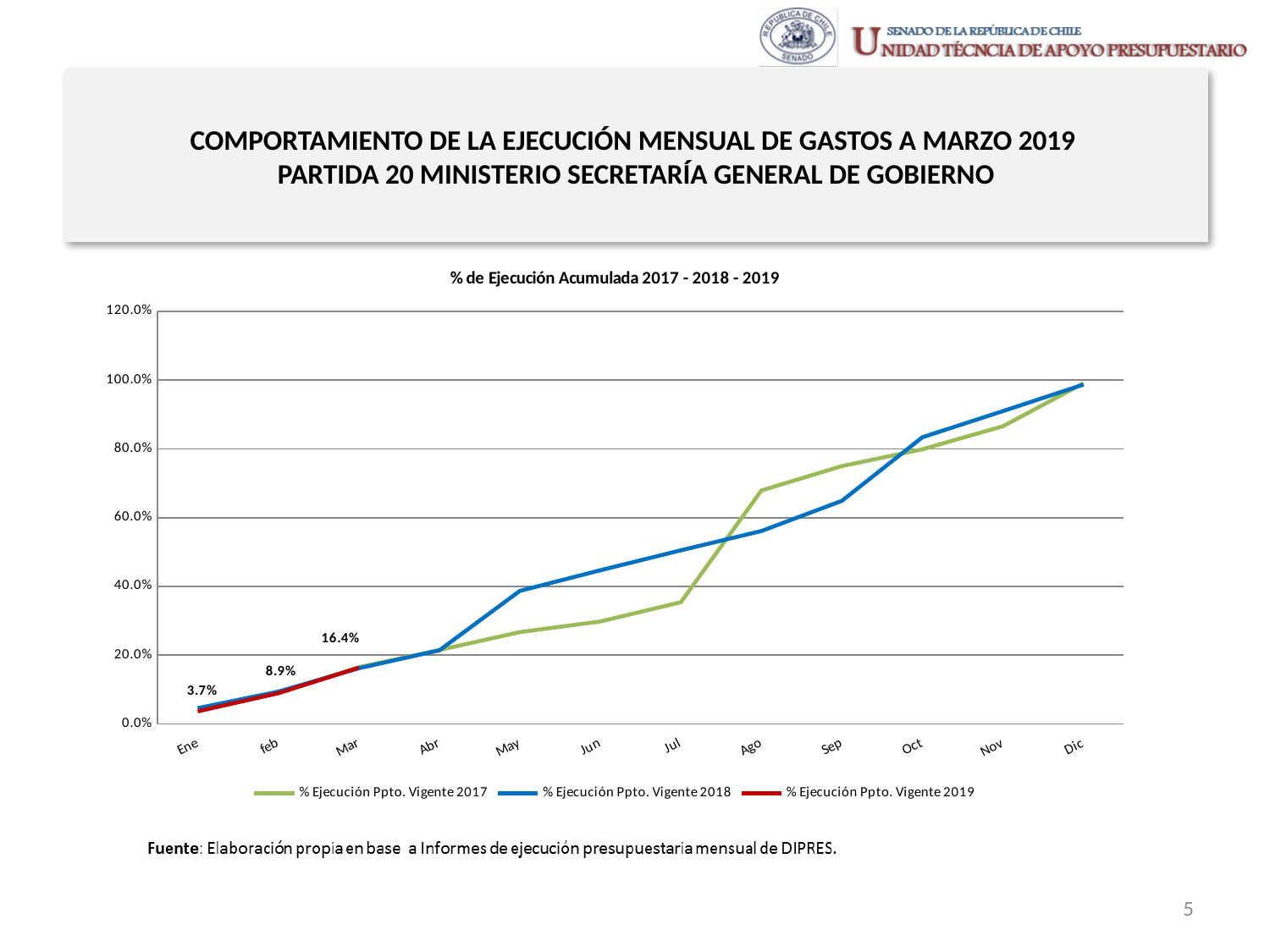
What is the value of % Ejecución Ppto. Vigente 2019 in Feb? 8.9% How many series does the legend list? 3 In Ago, which series has the larger value: % Ejecución Ppto. Vigente 2017 or % Ejecución Ppto. Vigente 2018? % Ejecución Ppto. Vigente 2017 What is the title of the chart? % de Ejecución Acumulada 2017 - 2018 - 2019 Is the value for % Ejecución Ppto. Vigente 2018 in May greater or less than 20.0%? greater Do the values of % Ejecución Ppto. Vigente 2018 rise or fall from Ene to Dic? Rise What is the difference between the 2019 values for Mar and Feb? 7.5% How many months are shown on the x axis? 12 What is the value of % Ejecución Ppto. Vigente 2019 in Mar? 16.4% What is the difference between the 2019 values for Feb and Ene? 5.2% What is the value of % Ejecución Ppto. Vigente 2019 in Ene? 3.7% What type of chart is shown on the slide? Line chart